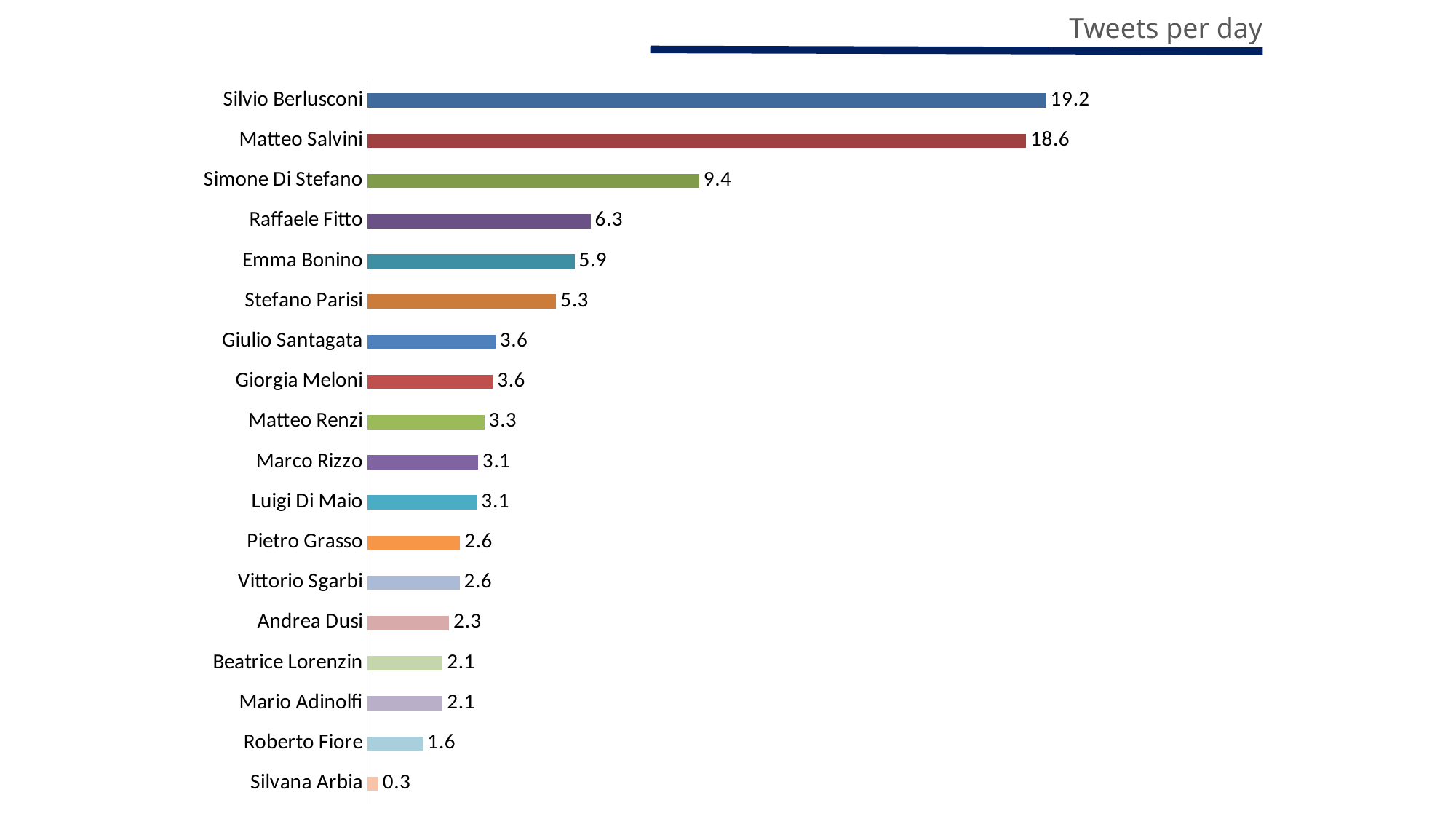
What is the title of the chart? Tweets per day Which person has the lowest value? Silvana Arbia What is the difference between the values for Silvio Berlusconi and Matteo Salvini? 0.6 What is the value for Andrea Dusi? 2.3 Which is larger, the value for Stefano Parisi or the value for Giulio Santagata? Stefano Parisi How many people are shown in the chart? 18 Which person has the highest value? Silvio Berlusconi What is the value for Emma Bonino? 5.9 What kind of chart is shown on the slide? Bar chart Which is larger, the value for Matteo Renzi or the value for Roberto Fiore? Matteo Renzi What is the value for Silvio Berlusconi? 19.2 What is the difference between the values for Simone Di Stefano and Raffaele Fitto? 3.1